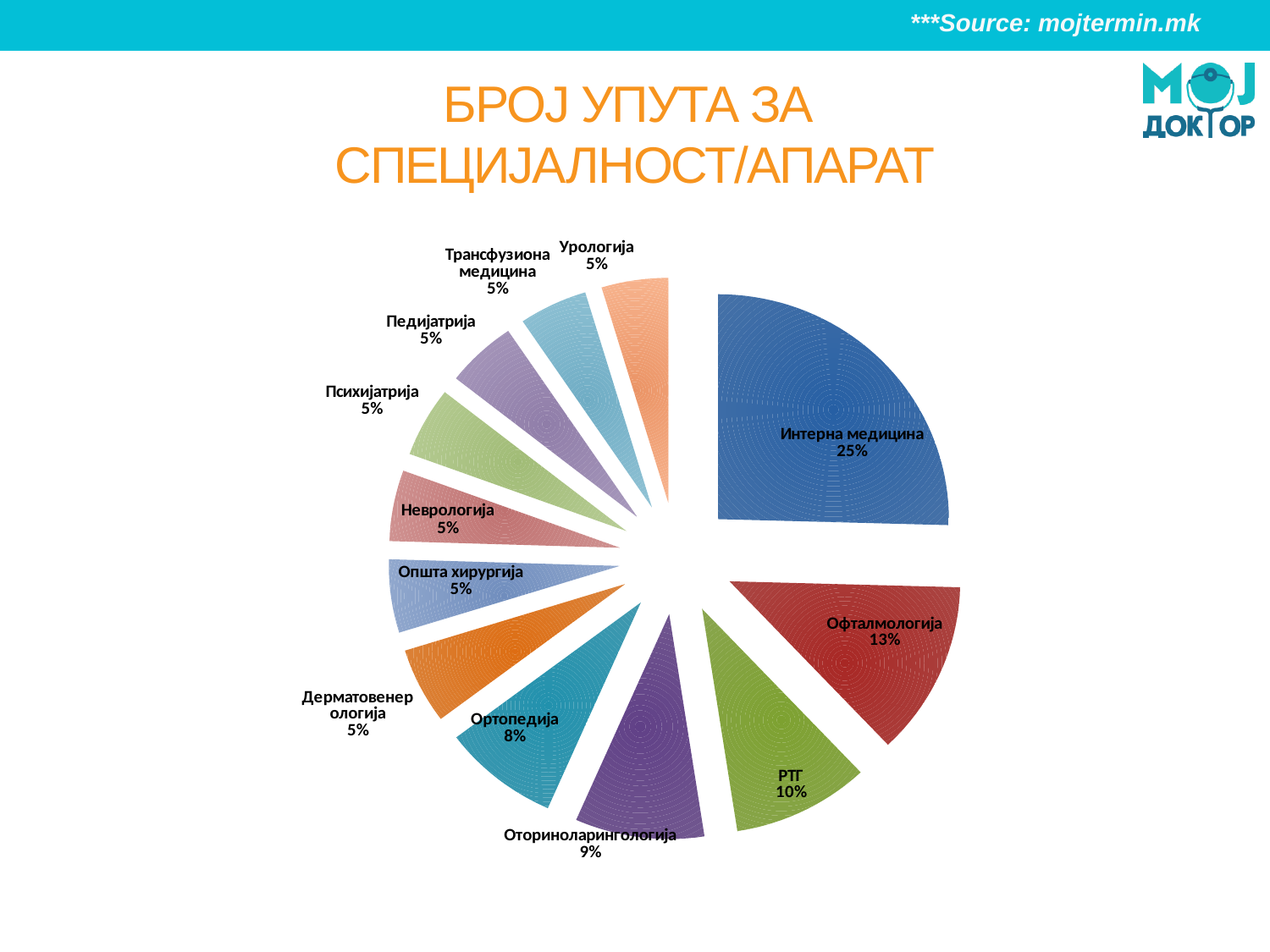
What is the title of the chart? БРОЈ УПУТА ЗА СПЕЦИЈАЛНОСТ/АПАРАТ What is the share for Урологија? 5% What is the share for РТГ? 10% What is the share for Интерна медицина? 25% How many slices does the pie chart have? 12 What is the share for Оториноларингологија? 9% What is the share for Ортопедија? 8% Which category has the largest share of the pie? Интерна медицина What kind of chart is shown on the slide? Pie chart What is the difference in percentage points between Интерна медицина and Офталмологија? 12 Which has a larger share, РТГ or Ортопедија? РТГ What is the share for Офталмологија? 13%